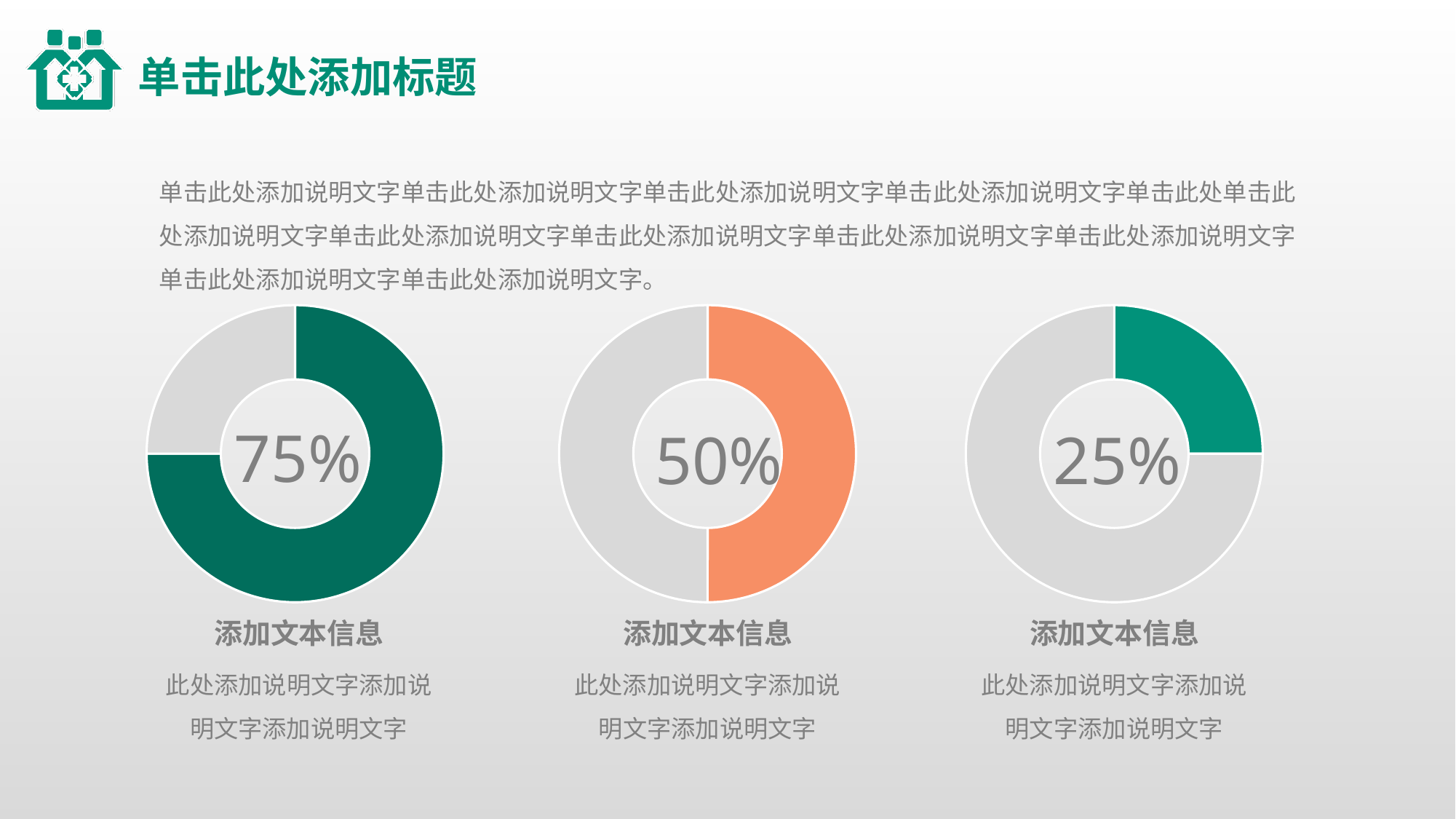
Which of the three doughnut charts shows the lowest percentage? The right chart (25%) Do the percentages rise or fall going from the left chart to the right chart? Fall What percentage is shown in the centre of the middle doughnut chart? 50% What colour is the filled portion of the middle doughnut chart? Orange How many doughnut charts are on the slide? 3 Which of the three doughnut charts shows the highest percentage? The left chart (75%) What percentage is shown in the centre of the left doughnut chart? 75% What kind of chart is used to display the percentages on the slide? Doughnut chart What is the difference between the percentage in the left doughnut chart and the percentage in the middle doughnut chart? 25% What percentage is shown in the centre of the right doughnut chart? 25% Which is larger, the percentage in the middle doughnut chart or the percentage in the right doughnut chart? The middle chart (50%) What is the difference between the percentage in the left doughnut chart and the percentage in the right doughnut chart? 50%